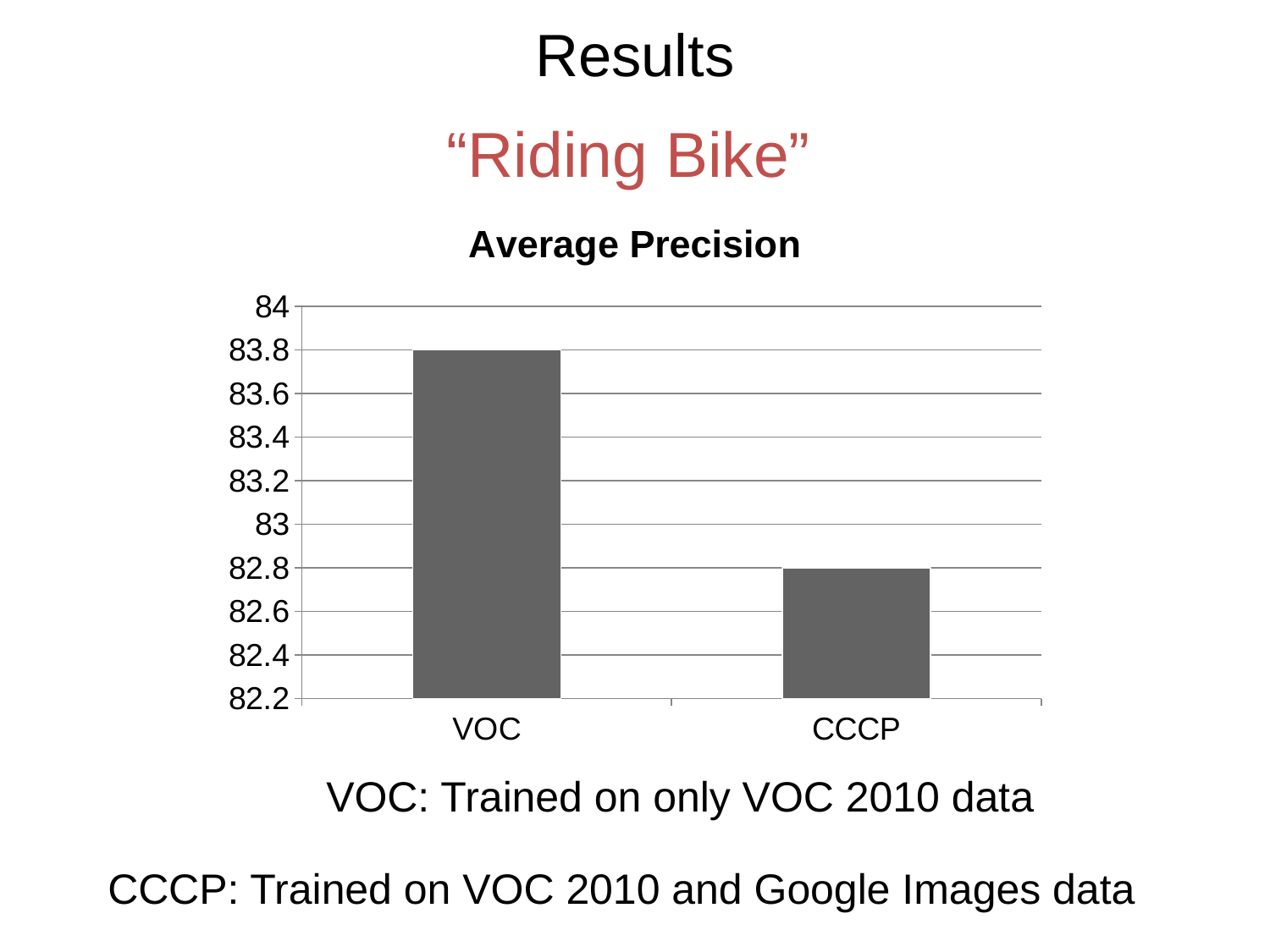
Is the value for VOC greater or less than 83.6? greater What is the title of the chart? Average Precision Is the value for CCCP greater or less than 83? less Which category has the highest Average Precision? VOC What kind of chart is shown on the slide? bar chart How many categories are shown on the x axis of the chart? 2 Which category has the lowest Average Precision? CCCP What is the Average Precision value for VOC? 83.8 What is the difference in Average Precision between VOC and CCCP? 1 What is the Average Precision value for CCCP? 82.8 Which has a larger Average Precision, VOC or CCCP? VOC What is the lowest value shown on the y axis of the chart? 82.2